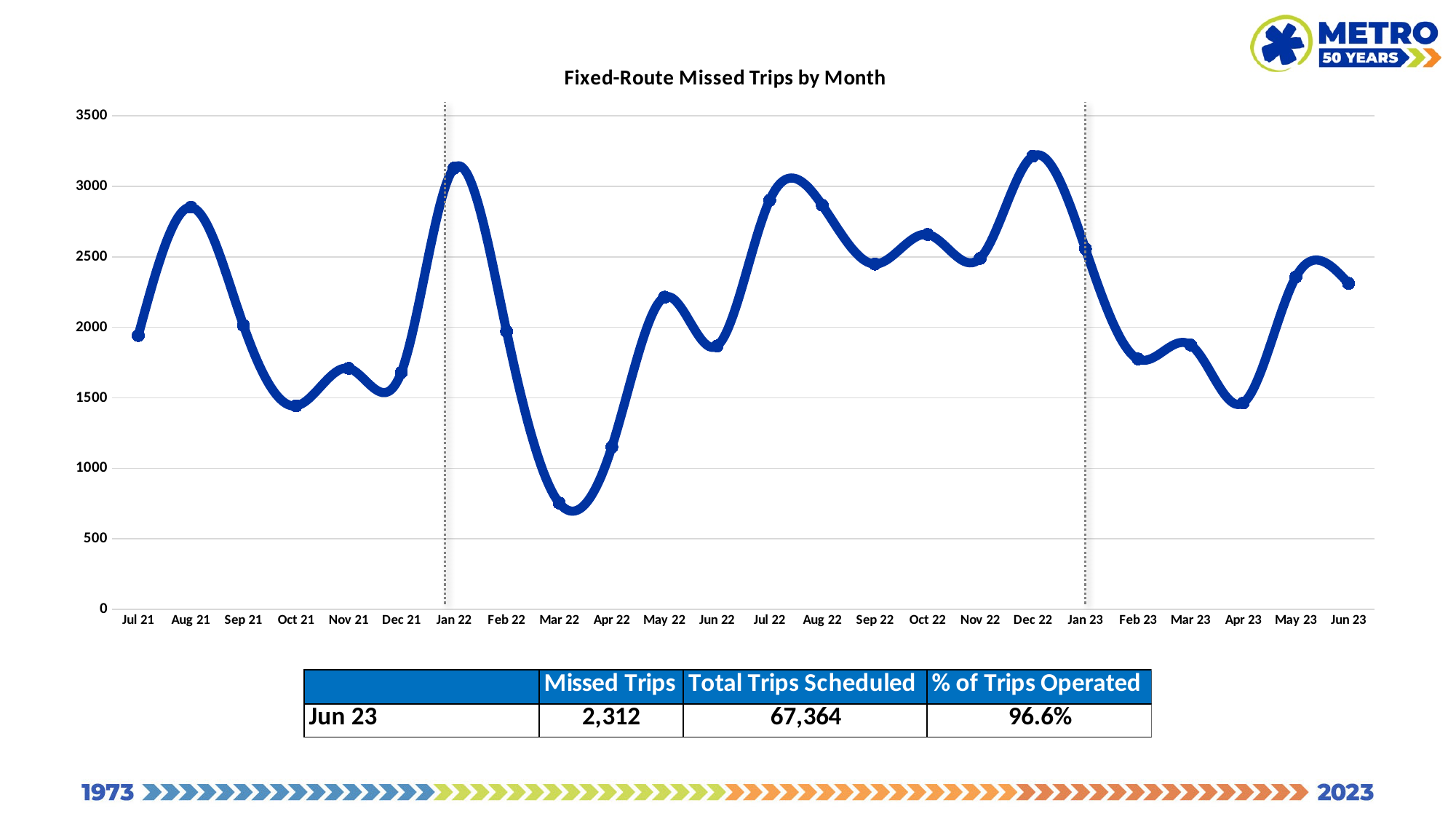
Which month has the lowest number of missed trips? Mar 22 At which two months are the dotted vertical lines drawn on the chart? Jan 22 and Jan 23 What is the title of the chart? Fixed-Route Missed Trips by Month Is the value for Apr 22 greater or less than 1500? less Is the value for Mar 22 greater or less than 1000? less Is the value for Jan 22 greater or less than 3000? greater Which month has more missed trips, Aug 21 or Oct 21? Aug 21 Do missed trips rise or fall from Jan 22 to Mar 22? fall How many months are plotted along the x axis of the chart? 24 Which month has the highest number of missed trips? Dec 22 What kind of chart is shown on the slide? line chart How many missed trips were there in Jun 23? 2,312